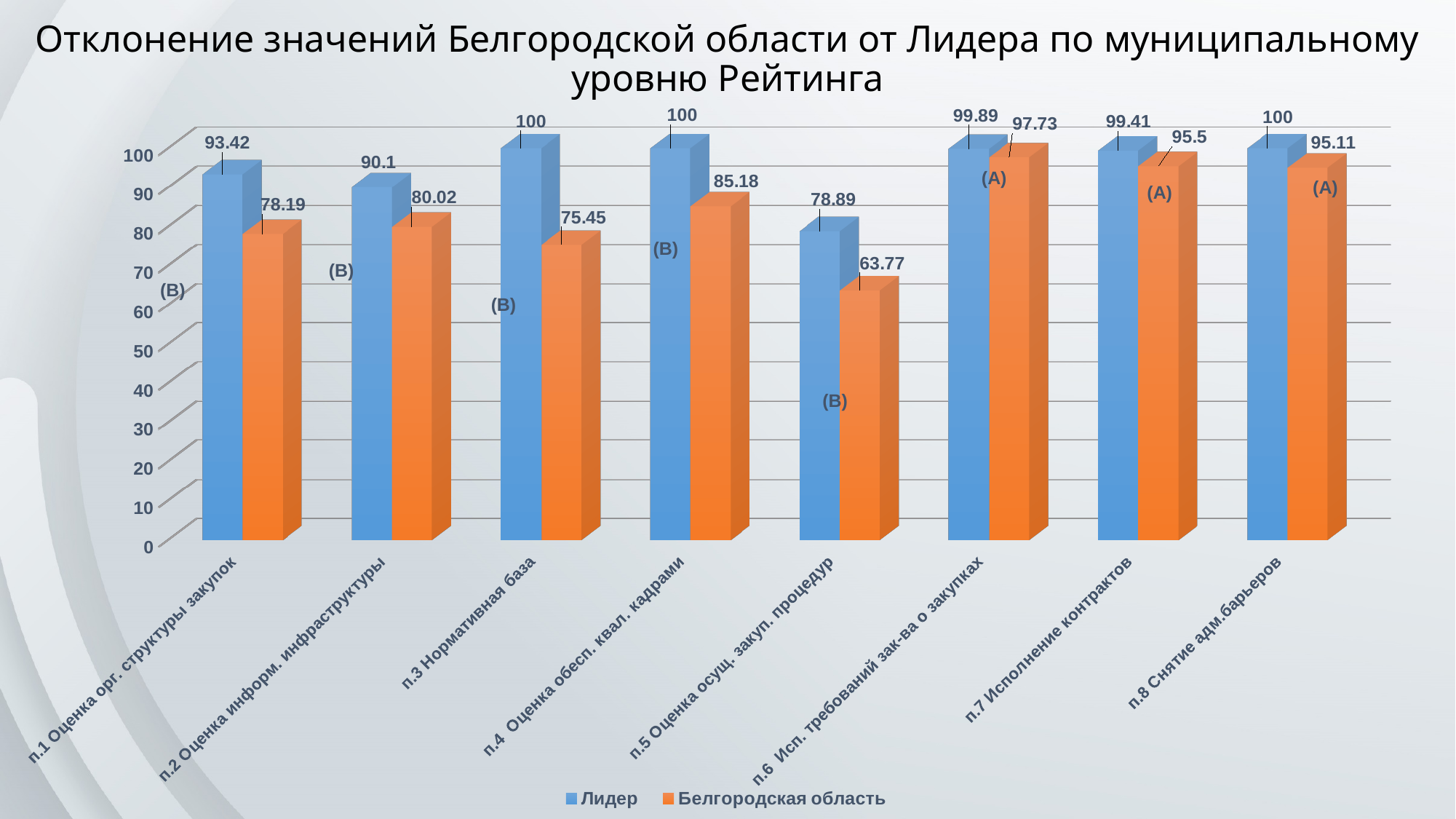
Which colour represents the series Белгородская область in the legend? Orange What is the difference between Лидер and Белгородская область in category п.3 Нормативная база? 24.55 How many categories are shown on the x axis? 8 Which is larger in category п.4 Оценка обесп. квал. кадрами: the value for Лидер or for Белгородская область? Лидер What is the difference between Лидер and Белгородская область in category п.7 Исполнение контрактов? 3.91 Which category has the lowest value for Белгородская область? п.5 Оценка осущ. закуп. процедур What is the value for Белгородская область in category п.6 Исп. требований зак-ва о закупках? 97.73 Which category has the highest value for Белгородская область? п.6 Исп. требований зак-ва о закупках What is the value for Лидер in category п.1 Оценка орг. структуры закупок? 93.42 What kind of chart is shown on the slide? Bar chart What is the value for Белгородская область in category п.5 Оценка осущ. закуп. процедур? 63.77 How many series does the legend list? 2